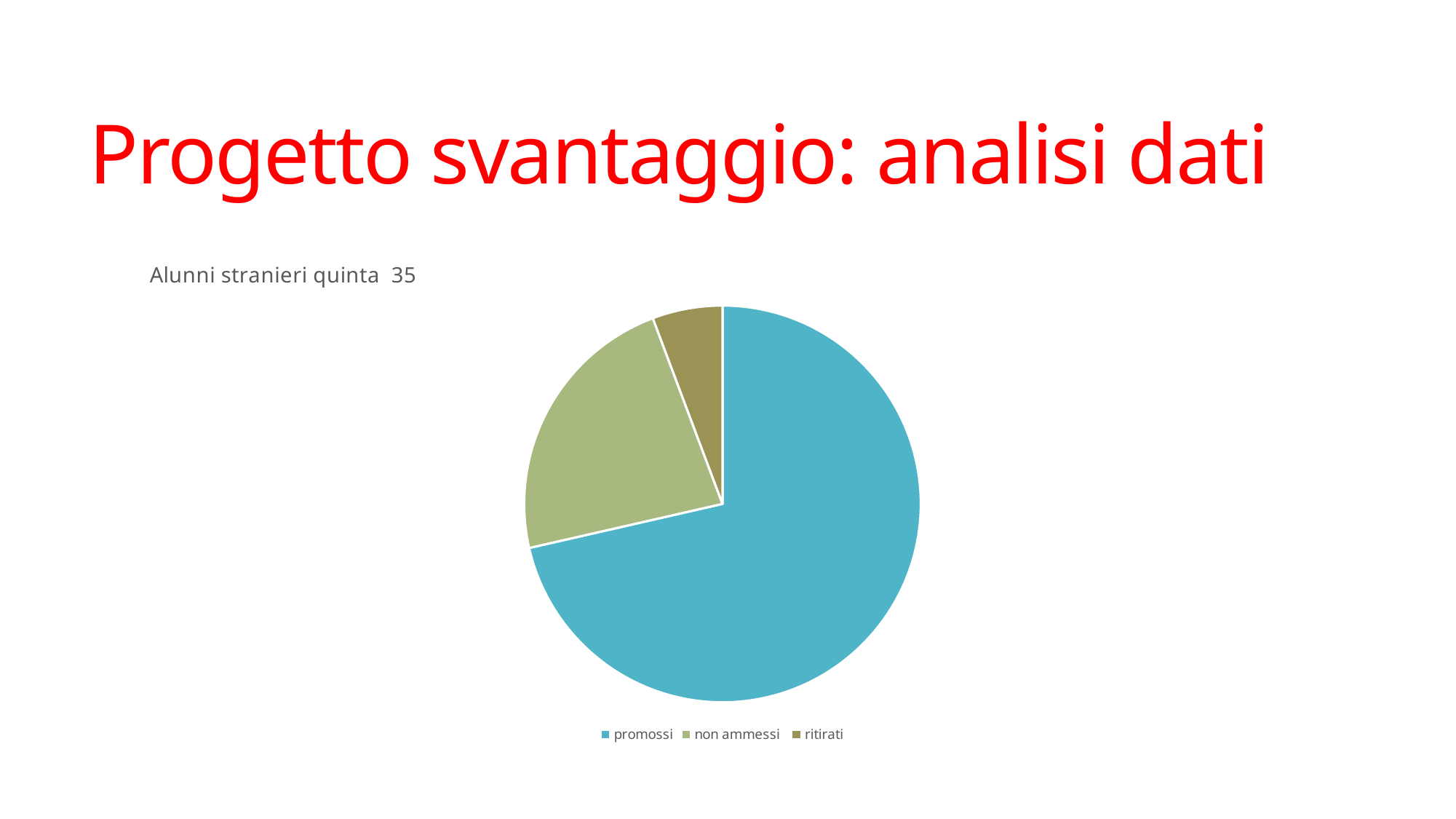
Which category has the smallest slice in the pie chart? ritirati What colour is the promossi slice in the pie chart? blue Which slice is larger, non ammessi or ritirati? non ammessi Which slice is larger, promossi or non ammessi? promossi How many slices does the pie chart have? 3 Which category has the largest slice in the pie chart? promossi What kind of chart is shown on the slide? pie chart What is the title shown above the pie chart? Alunni stranieri quinta 35 How many entries does the legend of the pie chart list? 3 Is the promossi slice more or less than half of the pie? more